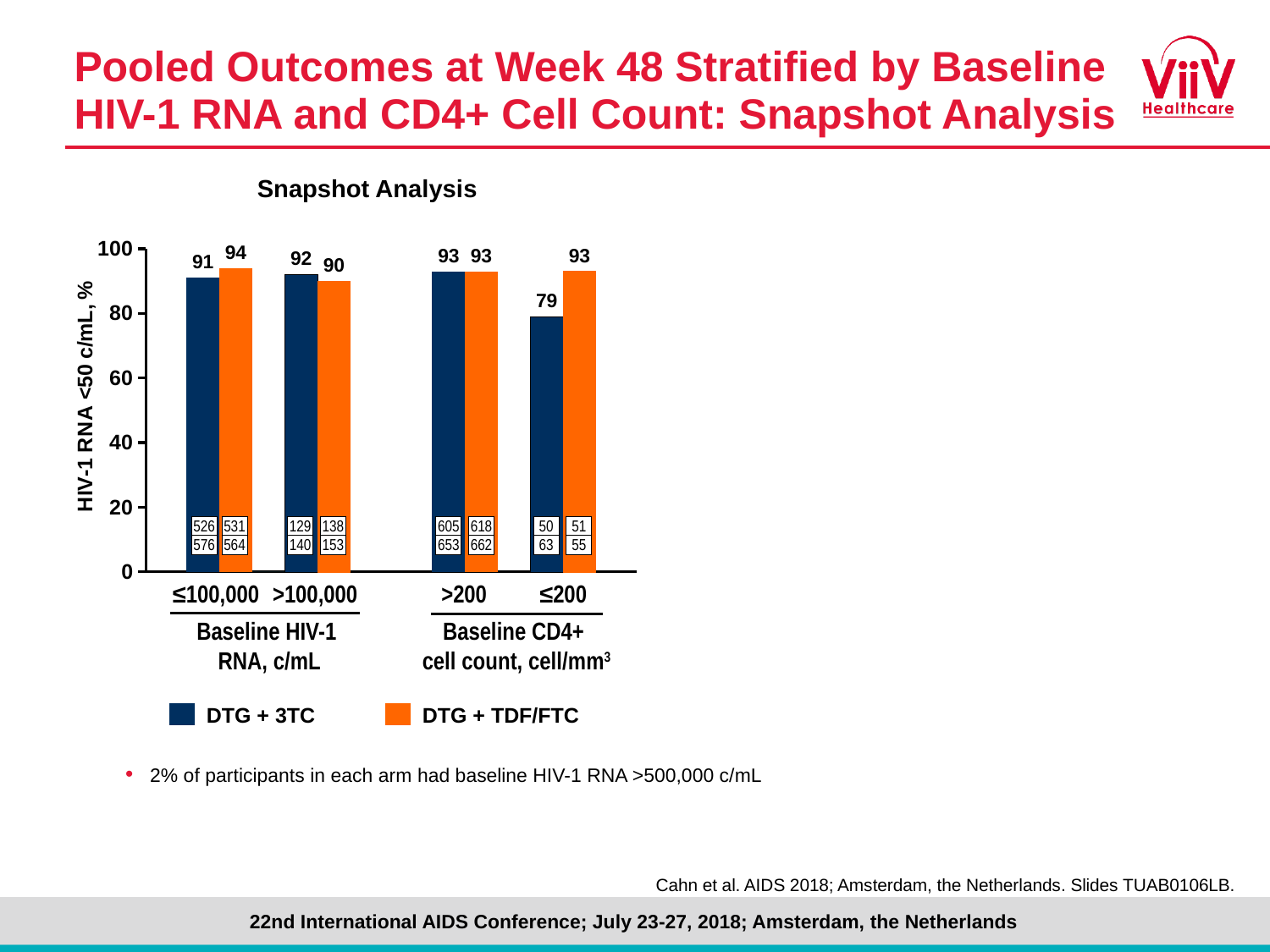
Which colour represents DTG + TDF/FTC in the legend? Orange What is the difference between DTG + TDF/FTC and DTG + 3TC in the ≤200 baseline CD4+ cell count category? 14 What is the value for DTG + 3TC in the ≤100,000 baseline HIV-1 RNA category? 91 What kind of chart is shown on the slide? Bar chart What is the value for DTG + TDF/FTC in the >100,000 baseline HIV-1 RNA category? 90 In the >100,000 baseline HIV-1 RNA category, which series has the larger value, DTG + 3TC or DTG + TDF/FTC? DTG + 3TC What is the value for DTG + 3TC in the ≤200 baseline CD4+ cell count category? 79 Which category has the lowest value for DTG + 3TC? ≤200 What is the value for DTG + TDF/FTC in the ≤200 baseline CD4+ cell count category? 93 How many categories are shown on the x axis? 4 How many series does the legend list? 2 Which category has the highest value for DTG + TDF/FTC? ≤100,000